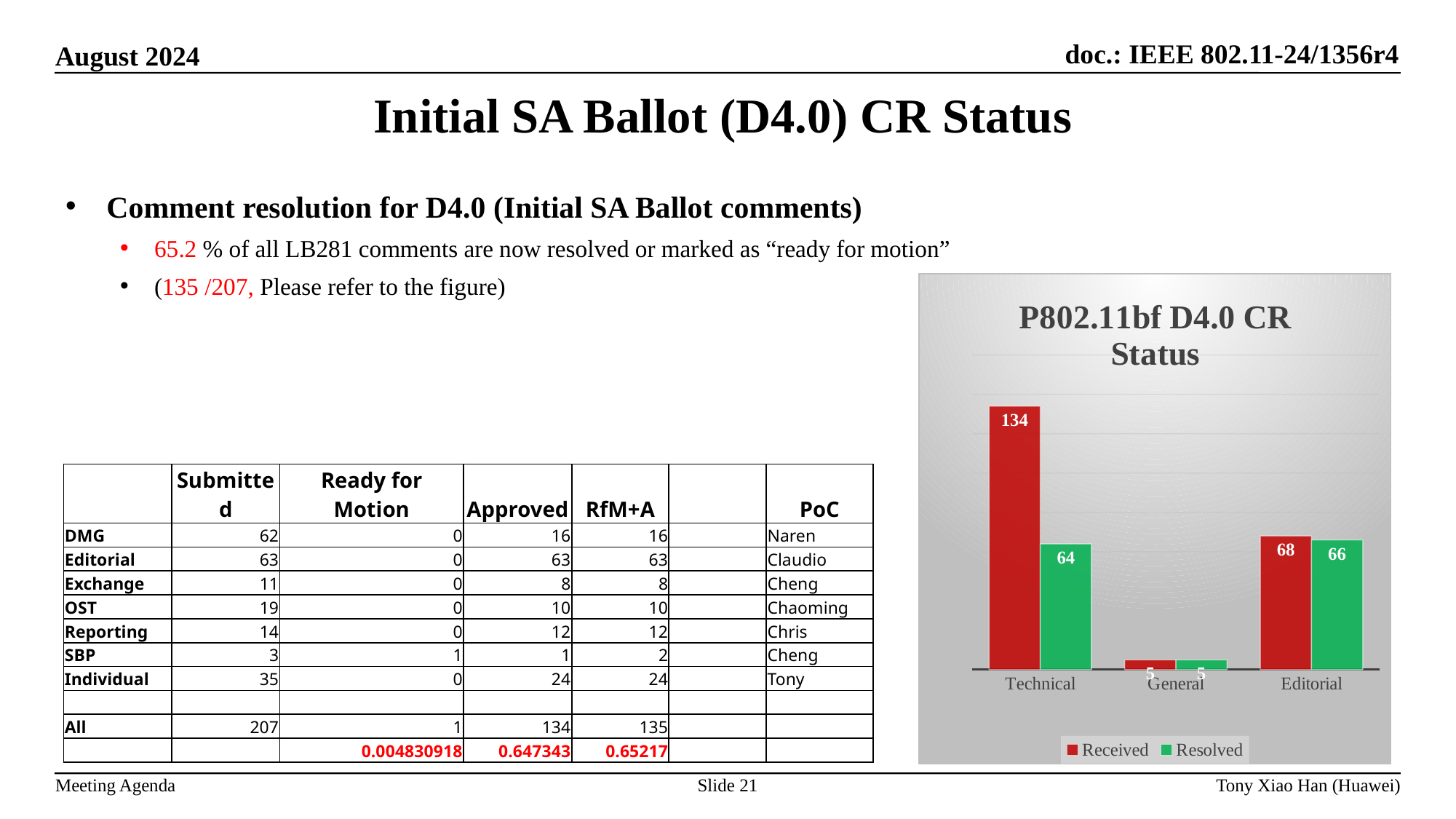
What is the title of the chart? P802.11bf D4.0 CR Status What is the Resolved value for Technical in the chart? 64 How many categories are shown on the x axis of the chart? 3 Is the Received value for Technical larger than the Received value for Editorial in the chart? Yes Which category has the lowest Resolved value in the chart? General What is the Received value for General in the chart? 5 What is the Received value for Technical in the chart? 134 How many series does the chart legend list? 2 What is the Resolved value for Editorial in the chart? 66 What is the difference between Received and Resolved for Technical in the chart? 70 What is the Received value for Editorial in the chart? 68 Which category has the highest Received value in the chart? Technical